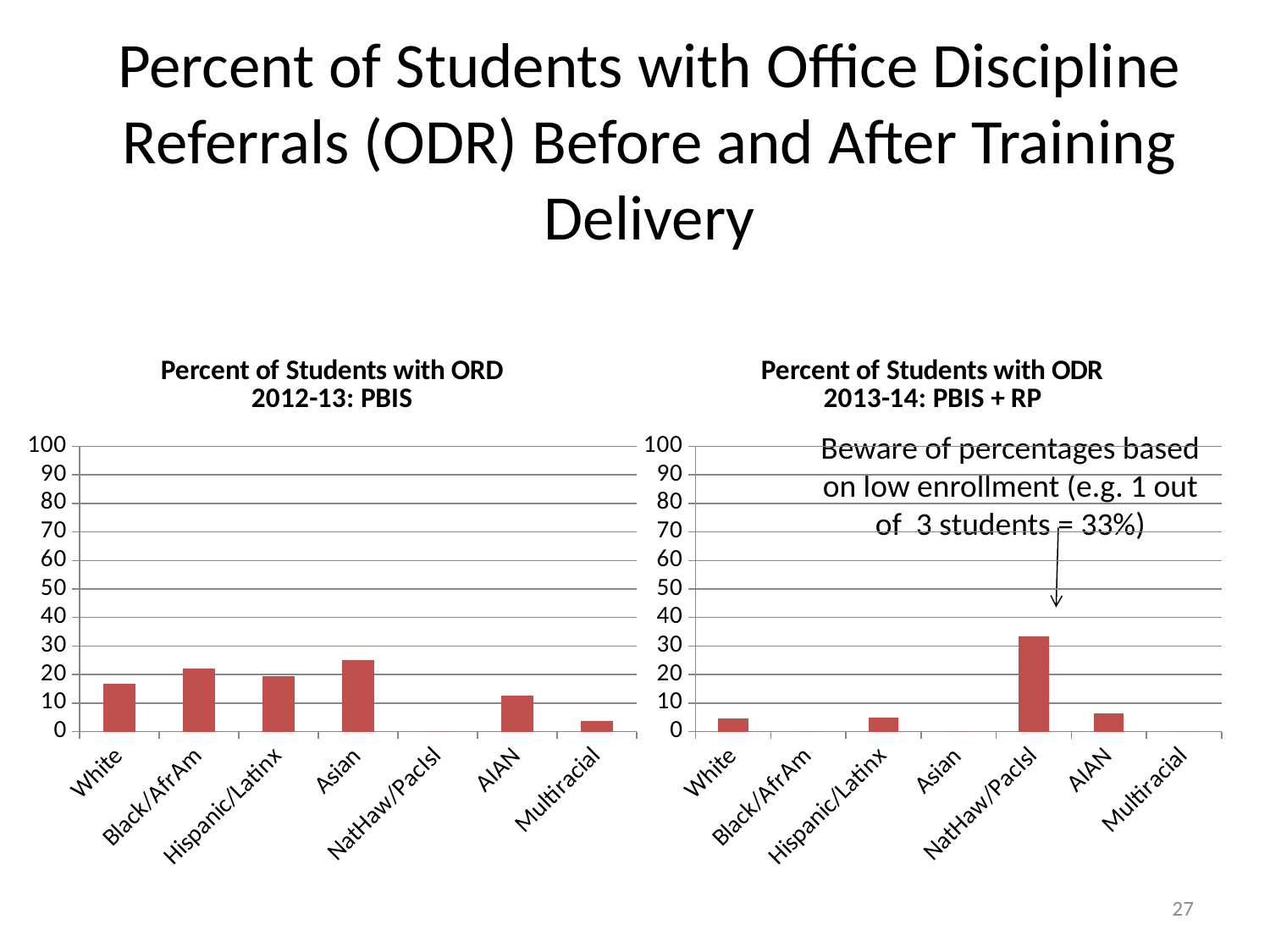
In the right chart, 'Percent of Students with ODR 2013-14: PBIS + RP', is the value for White greater or less than 10? less In the left chart, 'Percent of Students with ORD 2012-13: PBIS', which category has the highest bar? Asian In the right chart, 'Percent of Students with ODR 2013-14: PBIS + RP', is the value for NatHaw/PacIsl greater or less than 30? greater In the right chart, 'Percent of Students with ODR 2013-14: PBIS + RP', which category has the highest bar? NatHaw/PacIsl What kind of chart is the left chart, 'Percent of Students with ORD 2012-13: PBIS'? bar chart What is the title of the right chart? Percent of Students with ODR 2013-14: PBIS + RP In the left chart, 'Percent of Students with ORD 2012-13: PBIS', is the value for Asian greater or less than 20? greater In the left chart, 'Percent of Students with ORD 2012-13: PBIS', which is larger, the value for Black/AfrAm or the value for AIAN? Black/AfrAm What is the maximum value shown on the y axis of the left chart, 'Percent of Students with ORD 2012-13: PBIS'? 100 How many categories are shown on the x axis of the right chart, 'Percent of Students with ODR 2013-14: PBIS + RP'? 7 In the right chart, 'Percent of Students with ODR 2013-14: PBIS + RP', which is larger, the value for NatHaw/PacIsl or the value for AIAN? NatHaw/PacIsl